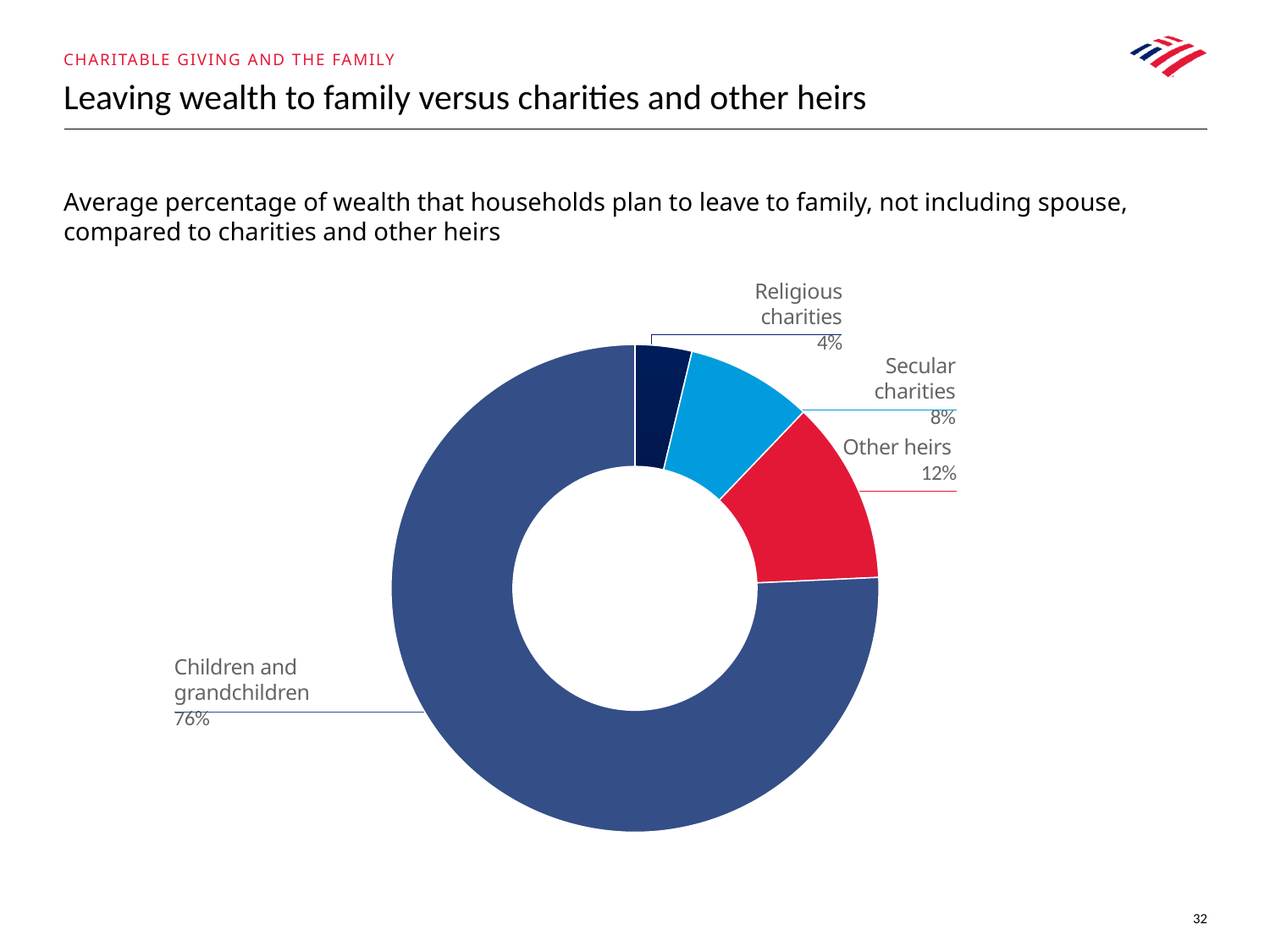
What percentage of wealth is planned for secular charities? 8% What kind of chart is shown on the slide? Pie chart (donut) Which category receives the smallest share of wealth? Religious charities What is the difference in percentage points between children and grandchildren and other heirs? 64 How many categories are shown in the chart? 4 What percentage of wealth is planned for other heirs? 12% What percentage of wealth do households plan to leave to children and grandchildren? 76% What percentage of wealth is planned for religious charities? 4% Which category receives the largest share of wealth? Children and grandchildren What is the difference in percentage points between other heirs and secular charities? 4 Which is larger: the share for secular charities or the share for religious charities? Secular charities What is the combined share of wealth planned for religious and secular charities? 12%